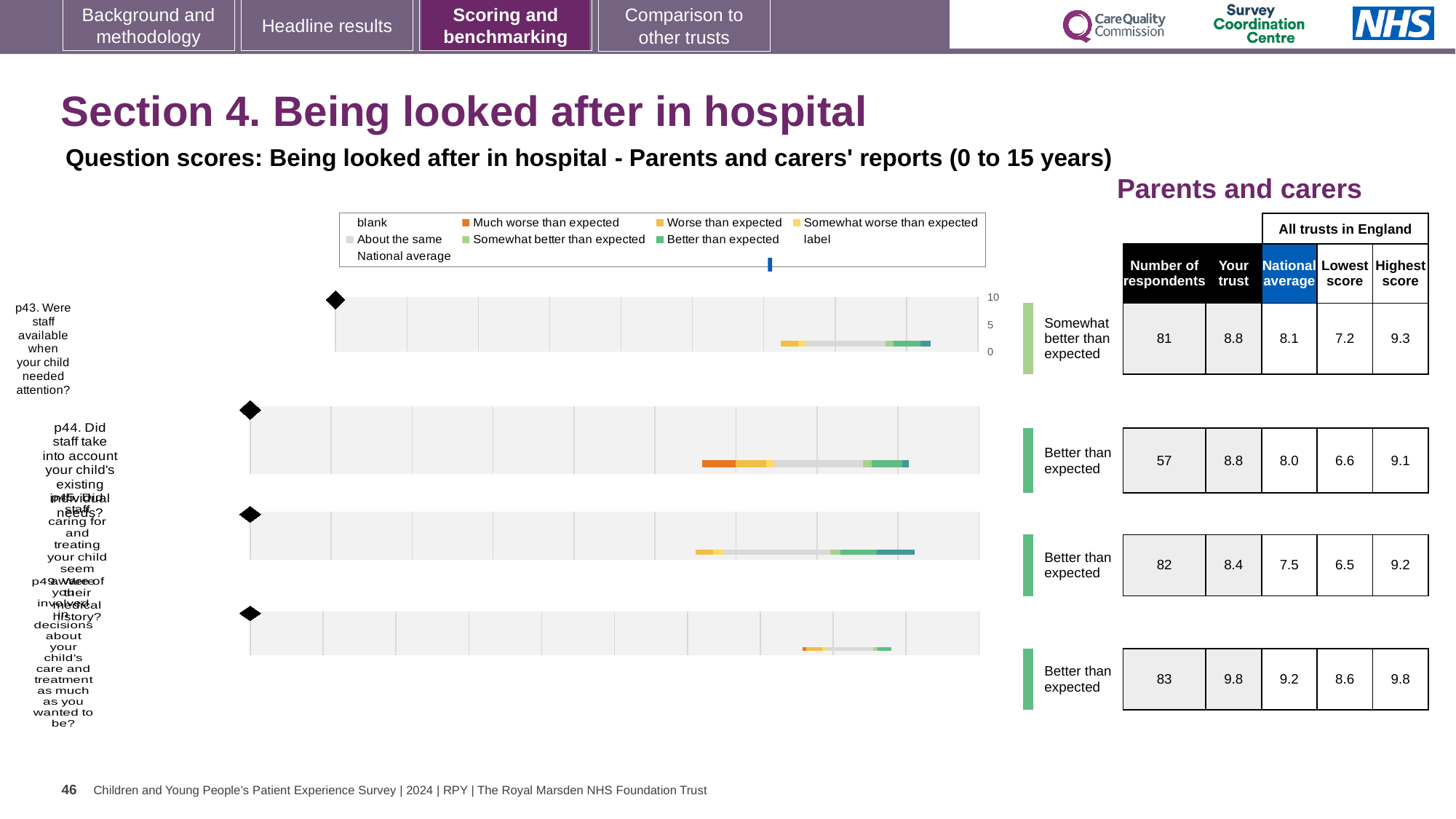
For the first chart (p43, Were staff available when your child needed attention?), what is the 'Your trust' score? 8.8 In the chart legend, which entry is shown with an orange colour? Much worse than expected For the first chart (p43), what is the difference between the 'Your trust' score and the national average? 0.7 What kind of chart is used to show the question scores on this slide? bar chart For the bottom chart (p49), what is the highest score among all trusts in England? 9.8 For the second chart (p44), what is the lowest score among all trusts in England? 6.6 In the chart legend, what does the blue marker represent? National average How many question charts are shown on the slide? 4 For the third chart, which is larger: the 'Your trust' score or the national average? Your trust Which of the four charts has the highest 'Your trust' score? the bottom chart (p49), 9.8 For the first chart (p43), how many respondents are there? 81 For the first chart (p43), what is the national average score? 8.1